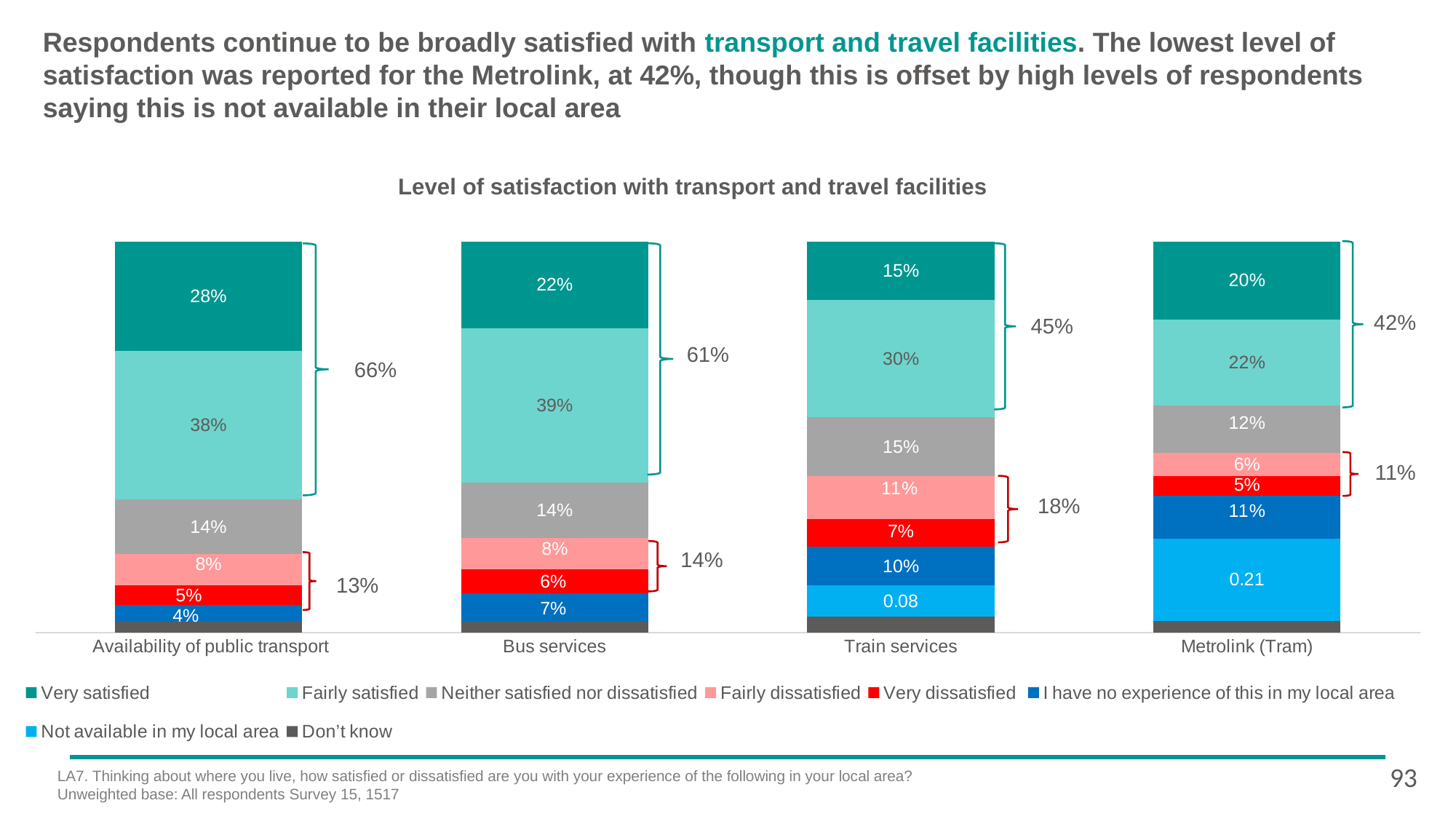
What is the 'Fairly satisfied' value for Train services? 30% What is the 'Not available in my local area' value shown for Metrolink (Tram)? 0.21 What is the 'Very satisfied' value for Bus services? 22% How many series does the chart legend list? 8 What is the difference between the 'Very satisfied' values for Availability of public transport and Train services? 13 percentage points What kind of chart is shown on the slide? Stacked bar chart Which category has the highest 'Very satisfied' value? Availability of public transport Which is larger: the 'Neither satisfied nor dissatisfied' value for Bus services or for Metrolink (Tram)? Bus services What is the title of the chart? Level of satisfaction with transport and travel facilities How many categories are shown along the x axis of the chart? 4 What is the 'I have no experience of this in my local area' value for Availability of public transport? 4% Which category has the lowest 'Very satisfied' value? Train services